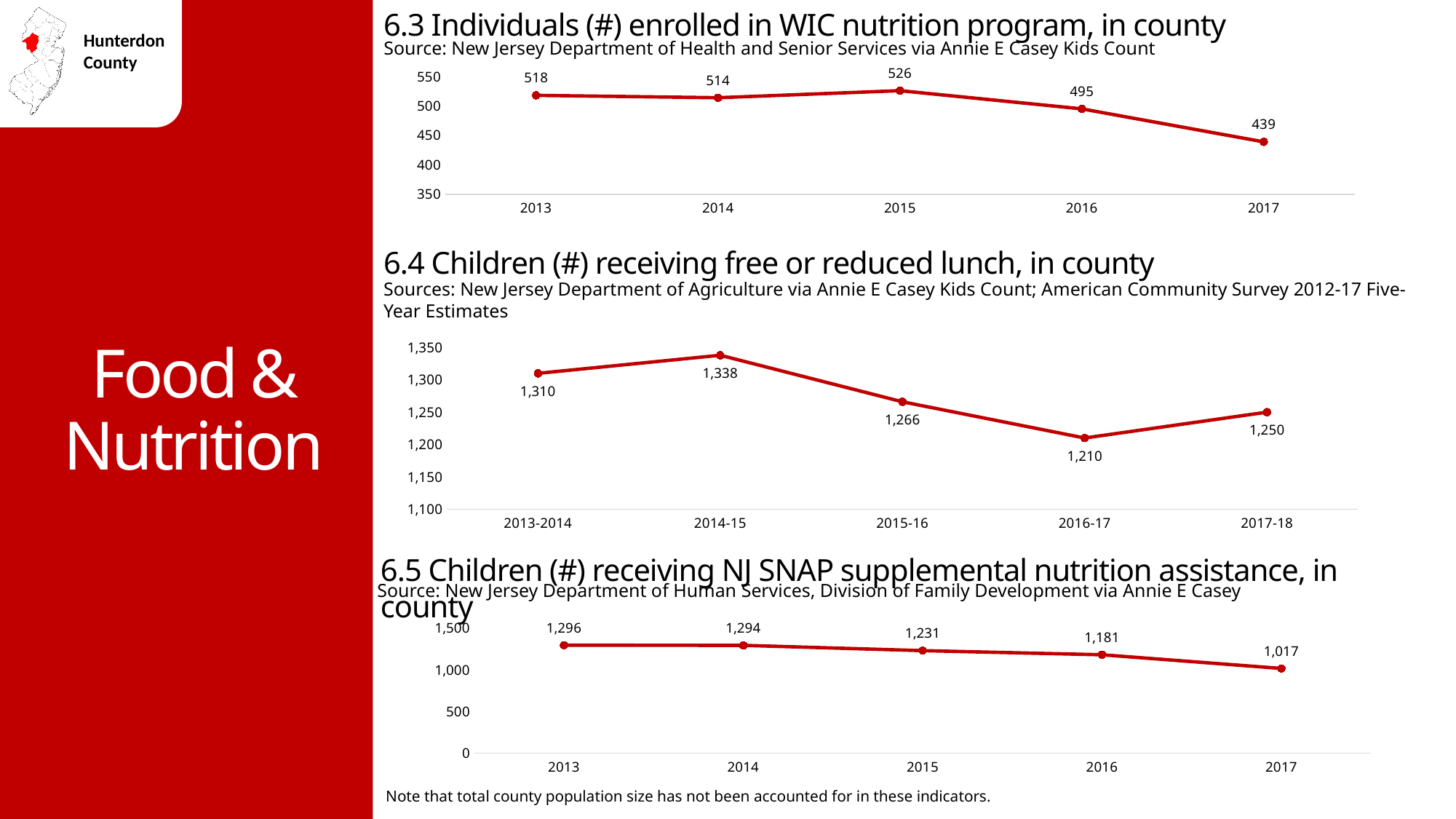
What kind of chart is '6.5 Children (#) receiving NJ SNAP supplemental nutrition assistance, in county'? line chart In the chart '6.4 Children (#) receiving free or reduced lunch, in county', is the value for 2015-16 larger or smaller than the value for 2017-18? larger How many charts are shown on the slide? 3 In the chart '6.3 Individuals (#) enrolled in WIC nutrition program, in county', what is the difference between the 2013 value and the 2017 value? 79 In the chart '6.4 Children (#) receiving free or reduced lunch, in county', which school year has the highest value? 2014-15 In the chart '6.5 Children (#) receiving NJ SNAP supplemental nutrition assistance, in county', what is the value for 2016? 1,181 In the chart '6.5 Children (#) receiving NJ SNAP supplemental nutrition assistance, in county', do the values rise or fall from 2013 to 2017? fall In the chart '6.3 Individuals (#) enrolled in WIC nutrition program, in county', how many years are plotted? 5 In the chart '6.3 Individuals (#) enrolled in WIC nutrition program, in county', which year has the lowest value? 2017 In the chart '6.4 Children (#) receiving free or reduced lunch, in county', what is the value for 2016-17? 1,210 In the chart '6.4 Children (#) receiving free or reduced lunch, in county', what is the difference between the 2014-15 value and the 2016-17 value? 128 In the chart '6.3 Individuals (#) enrolled in WIC nutrition program, in county', what is the value for 2015? 526